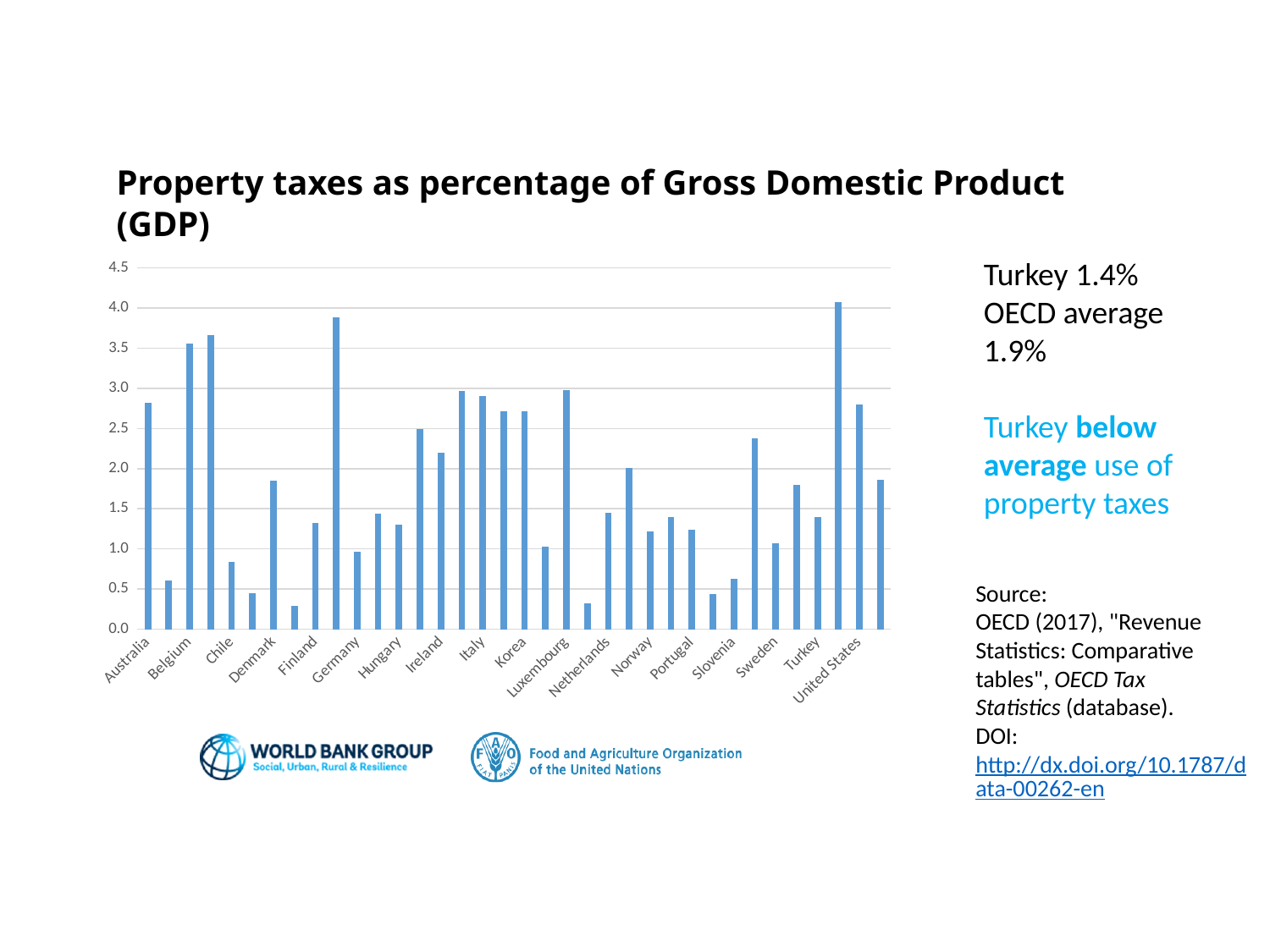
Which has the higher value, Belgium or Chile? Belgium Which has the higher value, Turkey or United States? United States Is the value for Turkey greater or less than 2.0? less What is the title of the chart? Property taxes as percentage of Gross Domestic Product (GDP) Is the value for Norway greater or less than 1.5? less What kind of chart is shown on the slide? bar chart Is the value for Australia greater or less than 2.5? greater Which has the higher value, Italy or Norway? Italy